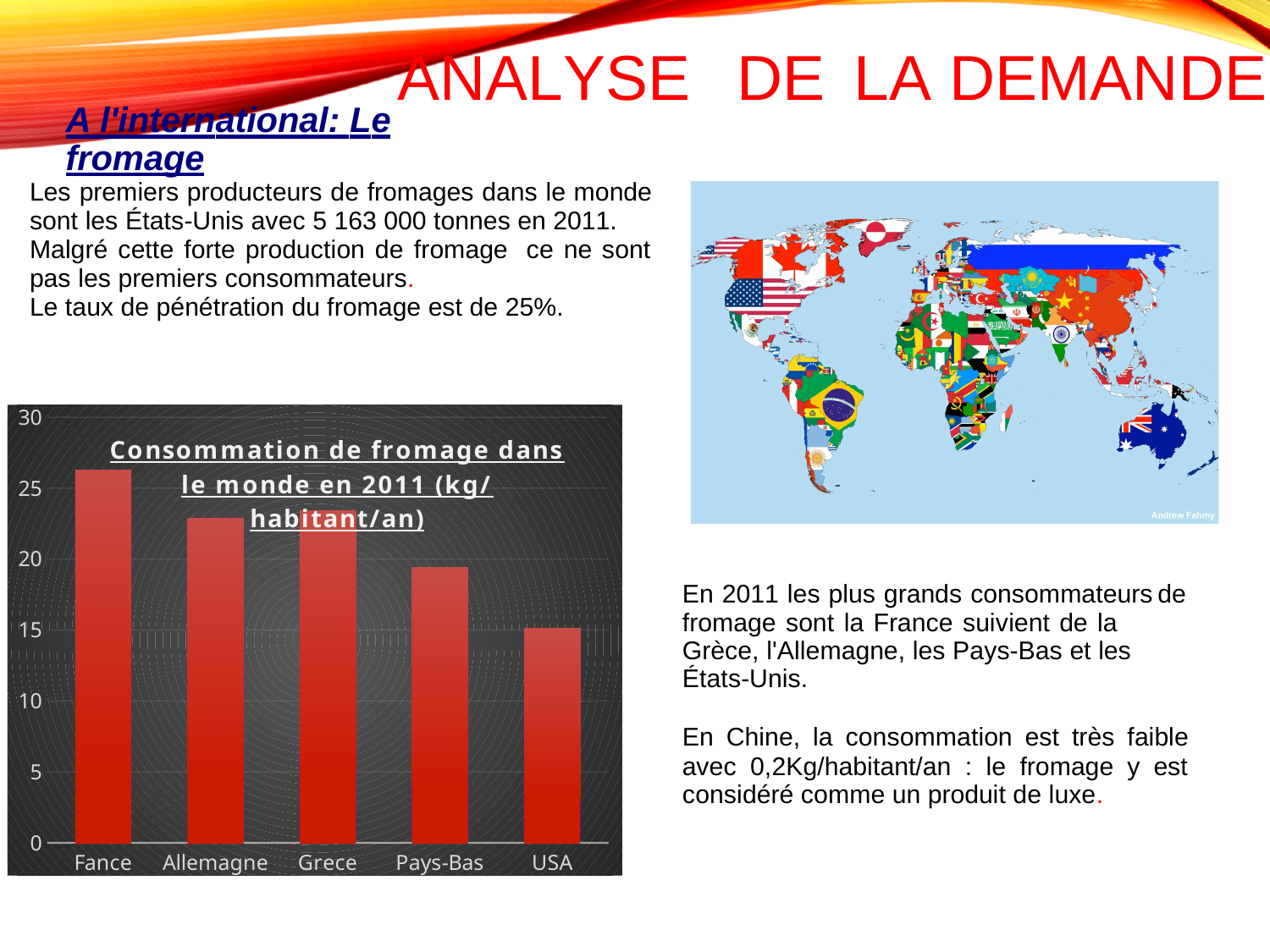
Which is larger, the value for Grece or the value for USA? Grece Is the value for Pays-Bas greater or less than 15? greater Is the value for Fance greater or less than 25? greater How many countries are shown on the x axis of the chart? 5 Which is larger, the value for Allemagne or the value for Pays-Bas? Allemagne What kind of chart is shown on the slide? Bar chart Is the value for Allemagne greater or less than 20? greater Which country has the highest cheese consumption in the chart? Fance What is the title of the chart? Consommation de fromage dans le monde en 2011 (kg/habitant/an) Which country has the lowest cheese consumption in the chart? USA